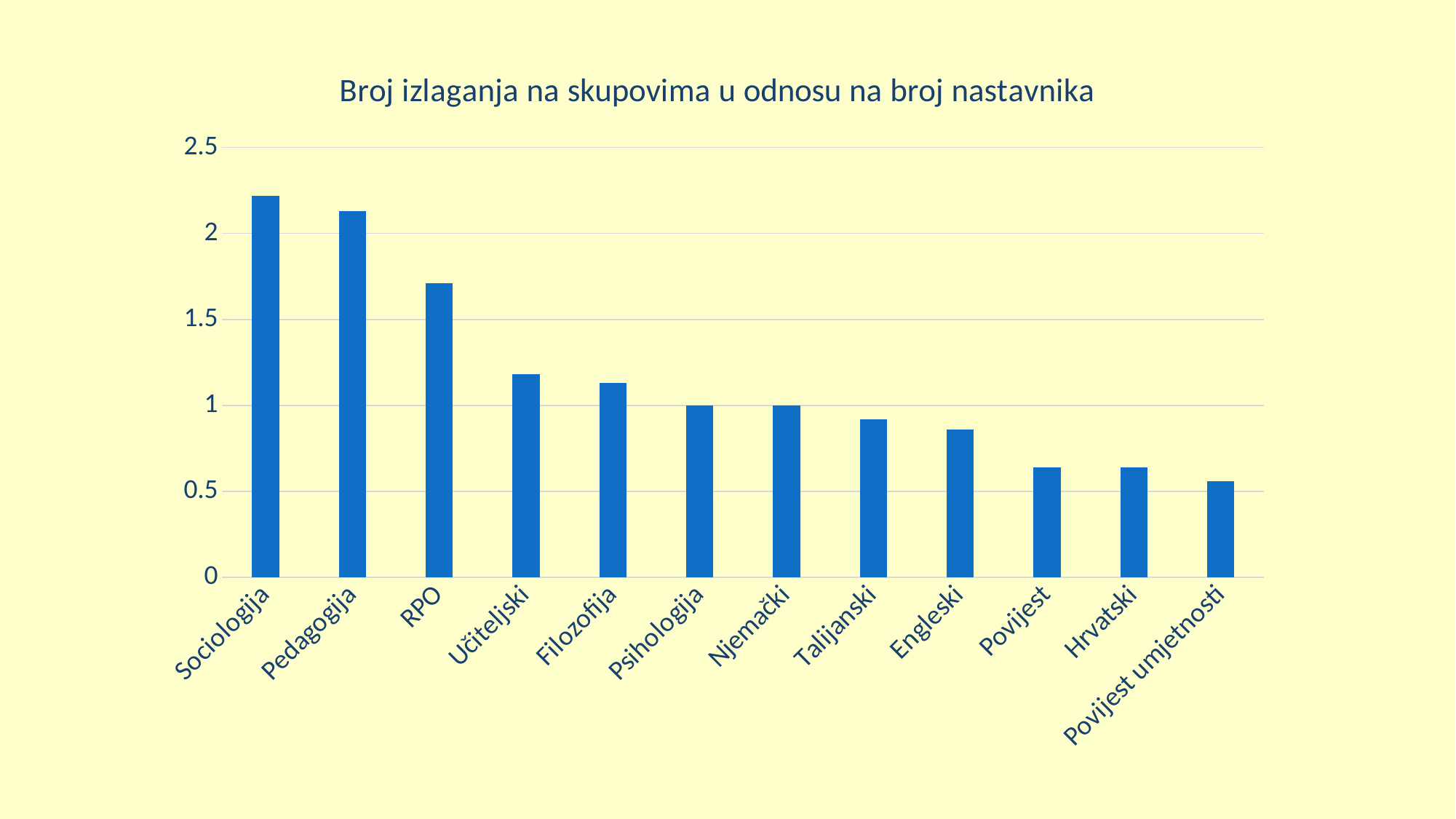
What kind of chart is shown on the slide? bar chart Is the value for Povijest greater or less than 0.5? greater Which category has the lowest value in the chart? Povijest umjetnosti Is the value for Engleski greater or less than 1? less What is the title of the chart? Broj izlaganja na skupovima u odnosu na broj nastavnika Is the value for RPO greater or less than 2? less Which has the larger value, RPO or Filozofija? RPO How many categories are shown on the x axis of the chart? 12 Which category has the highest value in the chart? Sociologija Do the values rise or fall moving from left to right along the x axis? fall